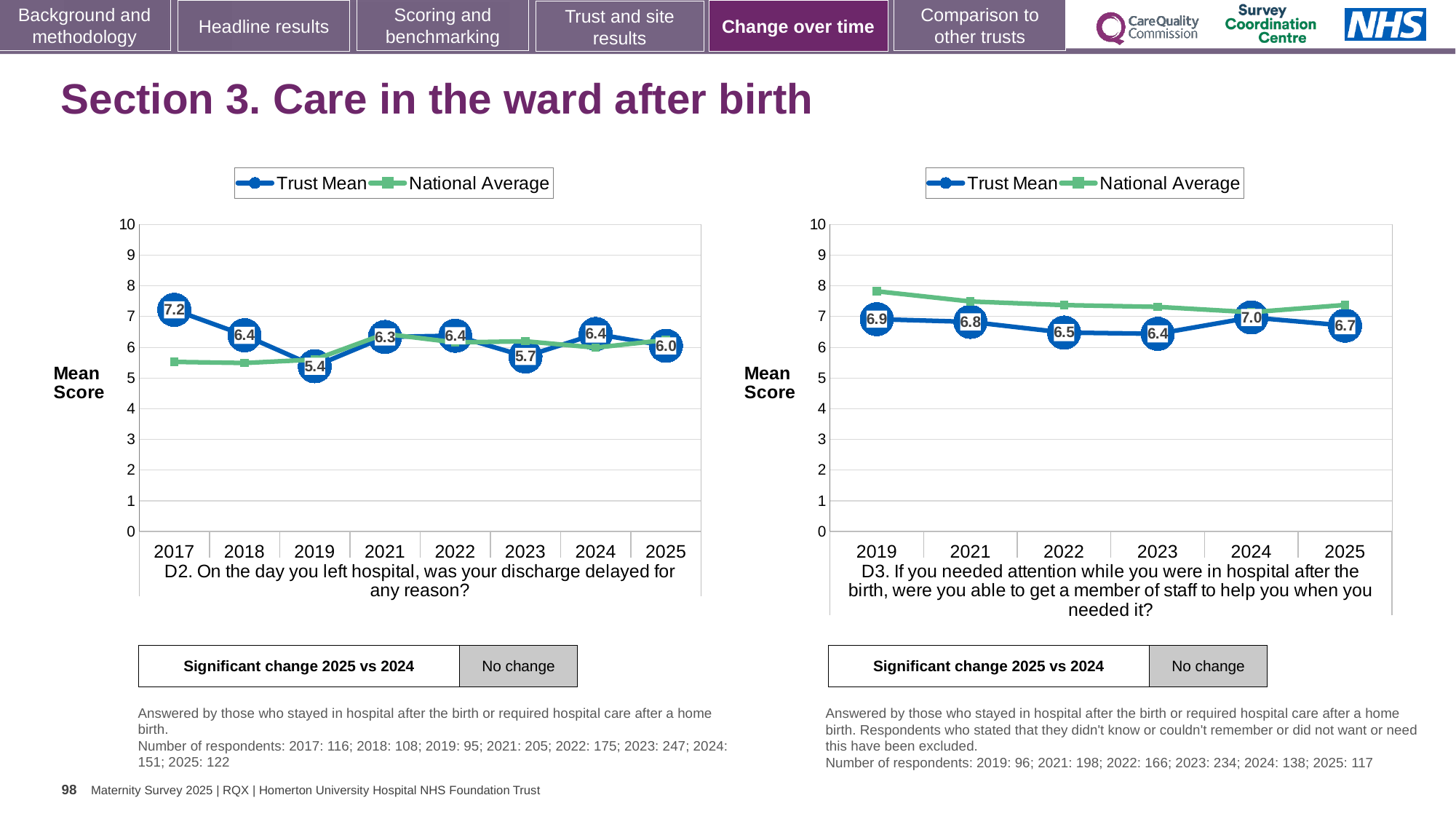
What type of chart is used for the D2 question on the left? Line chart In the D2 chart (left), what is the Trust Mean for 2025? 6.0 In the D2 chart (left), which year has the highest Trust Mean? 2017 In the D2 chart (left), what is the difference between the Trust Mean for 2017 and 2019? 1.8 In the D2 chart (left), what is the Trust Mean for 2017? 7.2 In the D2 chart (left), how many years are shown on the x axis? 8 In the D3 chart (right), how many series does the legend list? 2 In the D3 chart (right), is the National Average for 2019 greater or less than 7? greater In the D3 chart (right), which year has the lowest Trust Mean? 2023 In the D3 chart (right), is the Trust Mean for 2019 or 2022 larger? 2019 In the D3 chart (right), what is the Trust Mean for 2024? 7.0 In the D2 chart (left), which year has the lowest Trust Mean? 2019